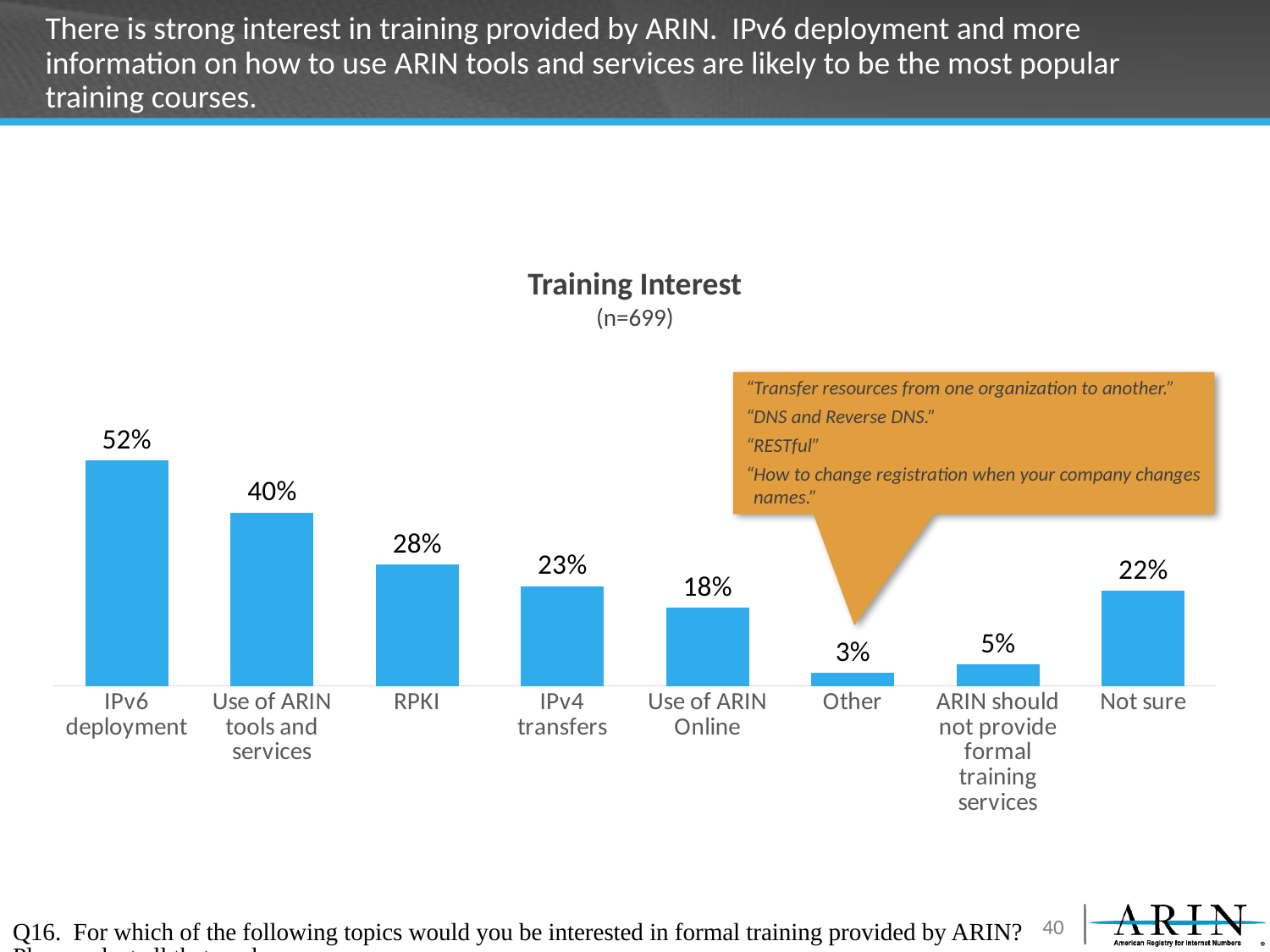
What sample size (n) is shown under the chart title? n=699 What kind of chart is shown? Bar chart Which is larger, IPv4 transfers or Use of ARIN Online? IPv4 transfers What is the value for RPKI? 28% What is the difference between IPv6 deployment and Use of ARIN tools and services? 12% What is the value for Use of ARIN tools and services? 40% Which category has the highest value? IPv6 deployment Which category has the lowest value? Other What is the value for Not sure? 22% What is the value for IPv6 deployment? 52% What is the title of the chart? Training Interest How many categories are shown in the chart? 8